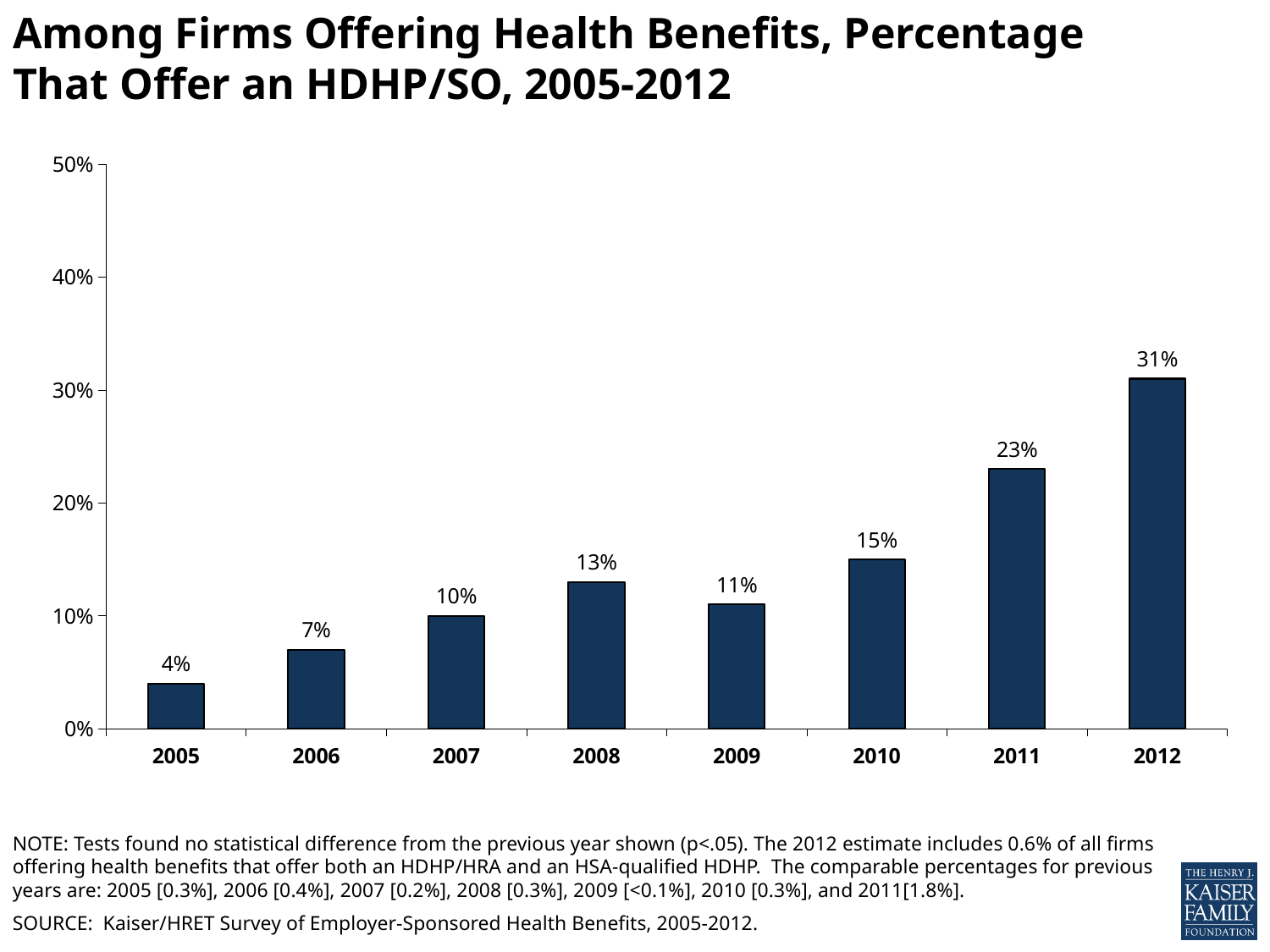
Is the value for 2011 greater or less than 20%? greater How many years are shown on the x axis? 8 Which year has the lowest percentage of firms offering an HDHP/SO? 2005 Which year has the highest percentage of firms offering an HDHP/SO? 2012 What is the overall trend in the percentage from 2005 to 2012? Rising What is the difference in percentage points between 2008 and 2009? 2 What is the value shown for 2005? 4% What percentage of firms offering health benefits offered an HDHP/SO in 2012? 31% What is the difference in percentage points between 2012 and 2011? 8 What kind of chart is shown on the slide? Bar chart Which year has a larger value, 2008 or 2009? 2008 What percentage is shown for 2009? 11%